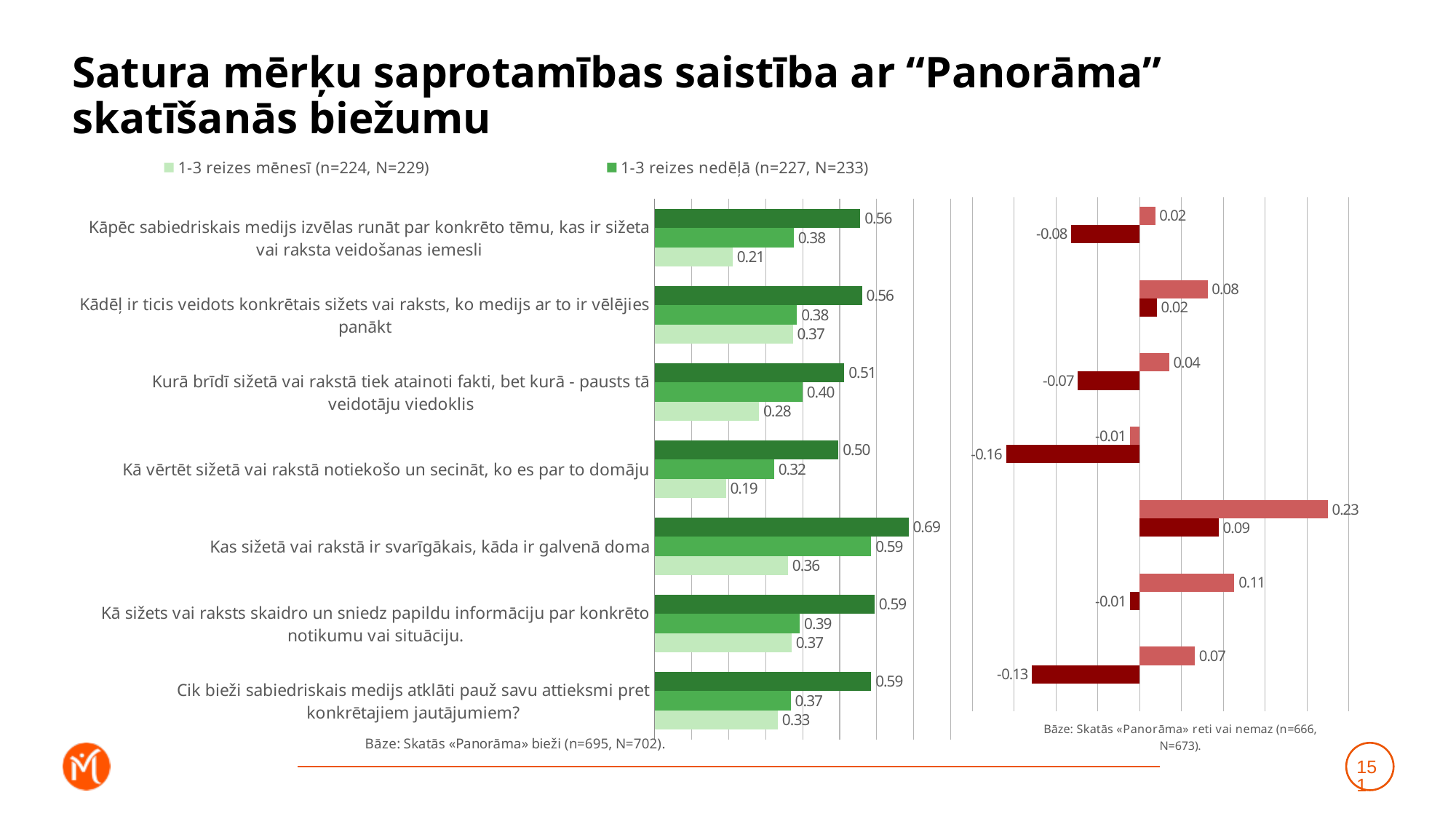
In the left chart, which category has the lowest value for '1-3 reizes mēnesī'? Kā vērtēt sižetā vai rakstā notiekošo un secināt, ko es par to domāju In the left chart, what is the value for '1-3 reizes mēnesī' for 'Kāpēc sabiedriskais medijs izvēlas runāt par konkrēto tēmu, kas ir sižeta vai raksta veidošanas iemesli'? 0.21 In the left chart, which is larger for 'Kurā brīdī sižetā vai rakstā tiek atainoti fakti, bet kurā - pausts tā veidotāju viedoklis': the '1-3 reizes nedēļā' value or the '1-3 reizes mēnesī' value? 1-3 reizes nedēļā In the left chart, what is the difference between the '1-3 reizes nedēļā' and '1-3 reizes mēnesī' values for 'Kas sižetā vai rakstā ir svarīgākais, kāda ir galvenā doma'? 0.23 In the left chart, what is the value for '1-3 reizes mēnesī' for 'Kā vērtēt sižetā vai rakstā notiekošo un secināt, ko es par to domāju'? 0.19 In the right chart, what is the highest value shown? 0.23 How many categories are shown in the left chart? 7 In the left chart, what is the value for '1-3 reizes nedēļā' for 'Kas sižetā vai rakstā ir svarīgākais, kāda ir galvenā doma'? 0.59 How many series does the legend above the left chart list? 2 In the left chart, which category has the highest value for '1-3 reizes nedēļā'? Kas sižetā vai rakstā ir svarīgākais, kāda ir galvenā doma What kind of chart is the left chart? Bar chart In the right chart, what is the lowest value shown? -0.16